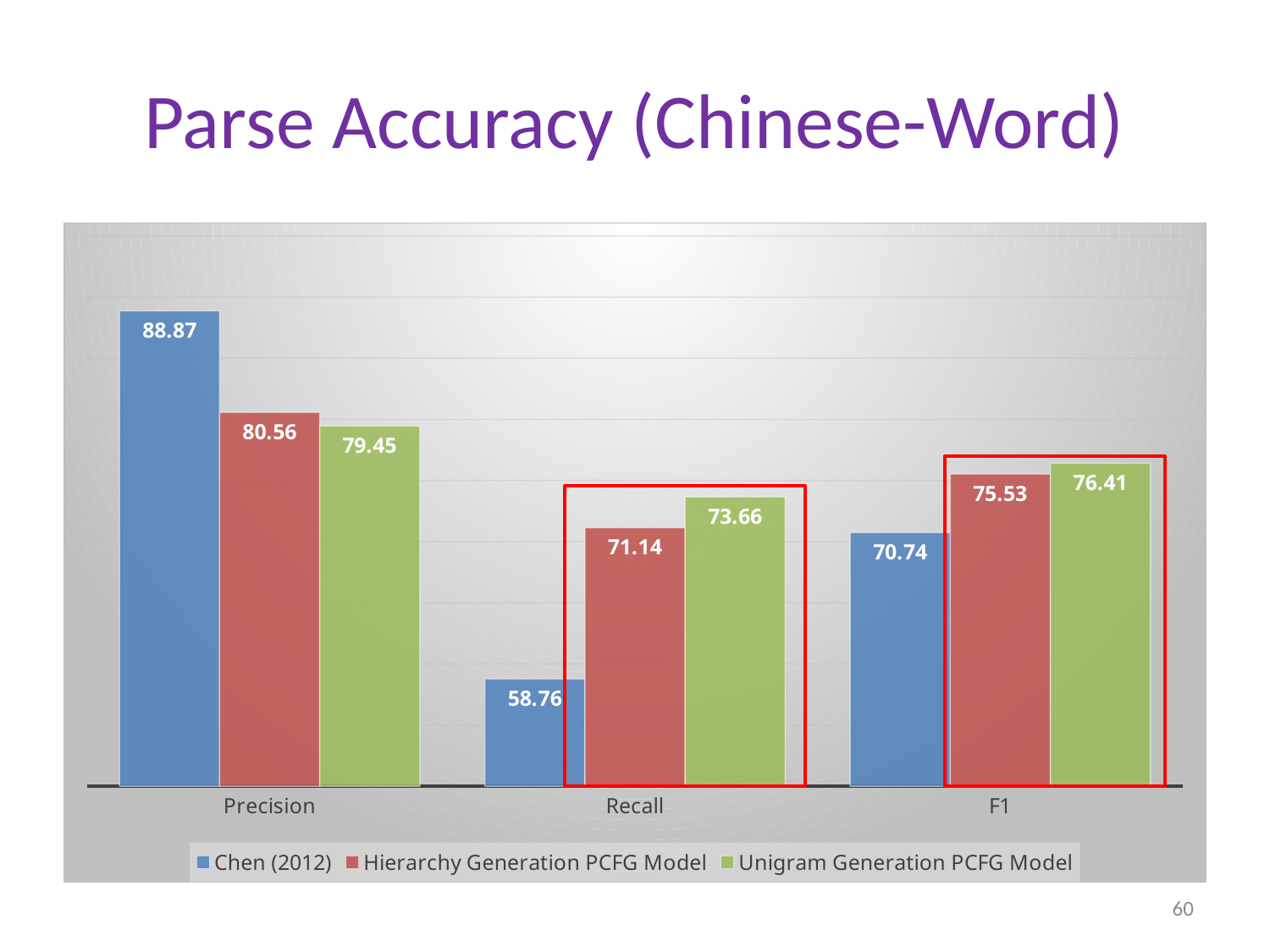
Which series has the highest Precision? Chen (2012) How many categories are shown on the x axis? 3 What is the title of the slide? Parse Accuracy (Chinese-Word) What is the Recall value for the Unigram Generation PCFG Model? 73.66 Which series has the lowest Recall? Chen (2012) What is the difference between the Recall of the Hierarchy Generation PCFG Model and Chen (2012)? 12.38 How many series does the legend list? 3 What kind of chart is shown on the slide? Bar chart What is the Precision value for Chen (2012)? 88.87 Which is larger, the F1 of the Unigram Generation PCFG Model or the Hierarchy Generation PCFG Model? Unigram Generation PCFG Model What is the F1 value for the Hierarchy Generation PCFG Model? 75.53 Which colour represents the Hierarchy Generation PCFG Model in the chart? Red